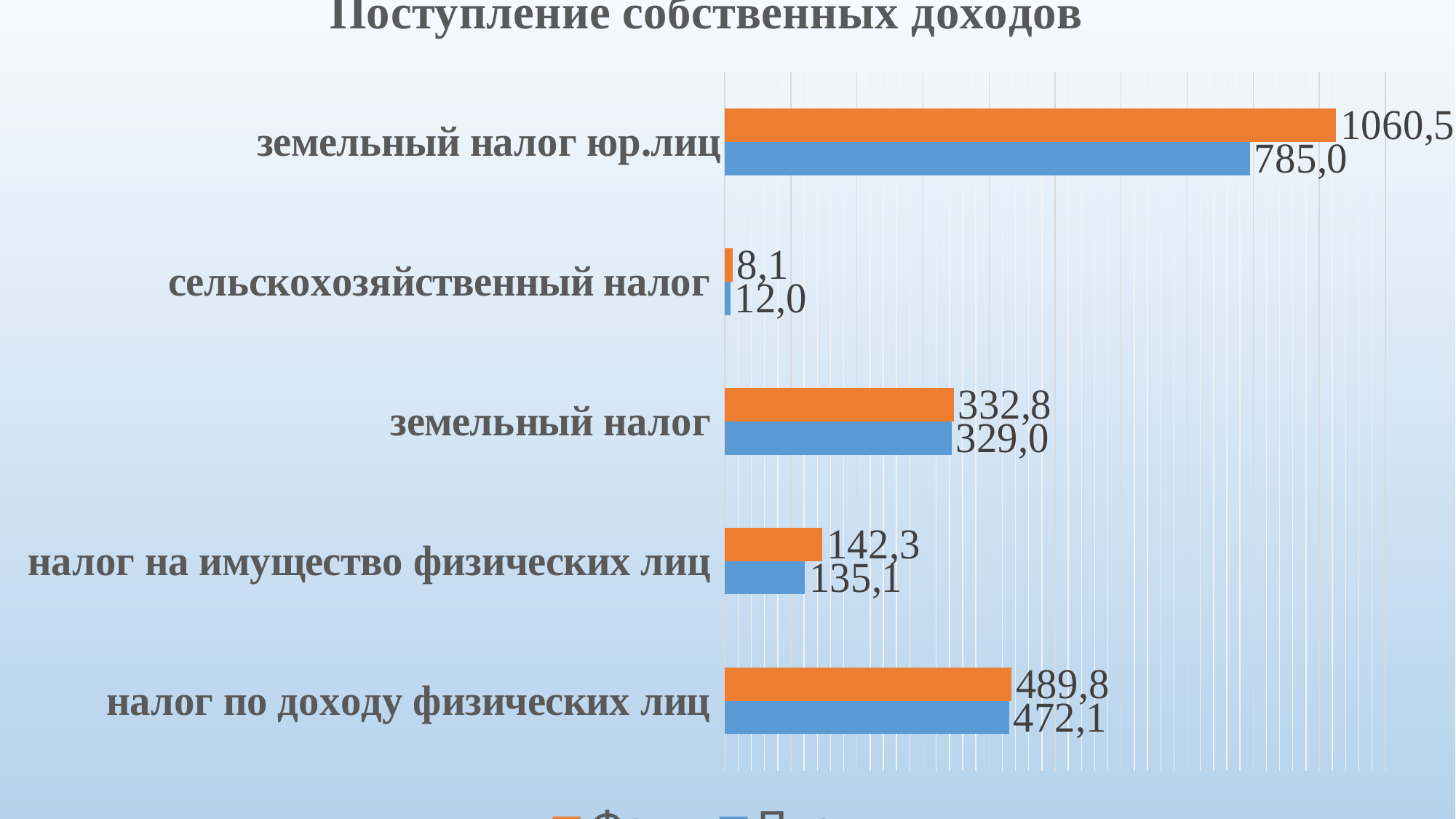
What is the value of the orange bar for земельный налог юр.лиц? 1060,5 Which category has the lowest blue bar value? сельскохозяйственный налог How many series does the legend list? 2 How many categories are shown on the chart? 5 What is the difference between the orange and blue values for земельный налог юр.лиц? 275,5 What kind of chart is shown on the slide? bar chart What is the difference between the blue and orange values for сельскохозяйственный налог? 3,9 Which category has the highest orange bar value? земельный налог юр.лиц For сельскохозяйственный налог, which is larger: the orange bar or the blue bar? the blue bar What is the value of the blue bar for сельскохозяйственный налог? 12,0 What is the value of the blue bar for налог на имущество физических лиц? 135,1 What is the value of the orange bar for налог по доходу физических лиц? 489,8